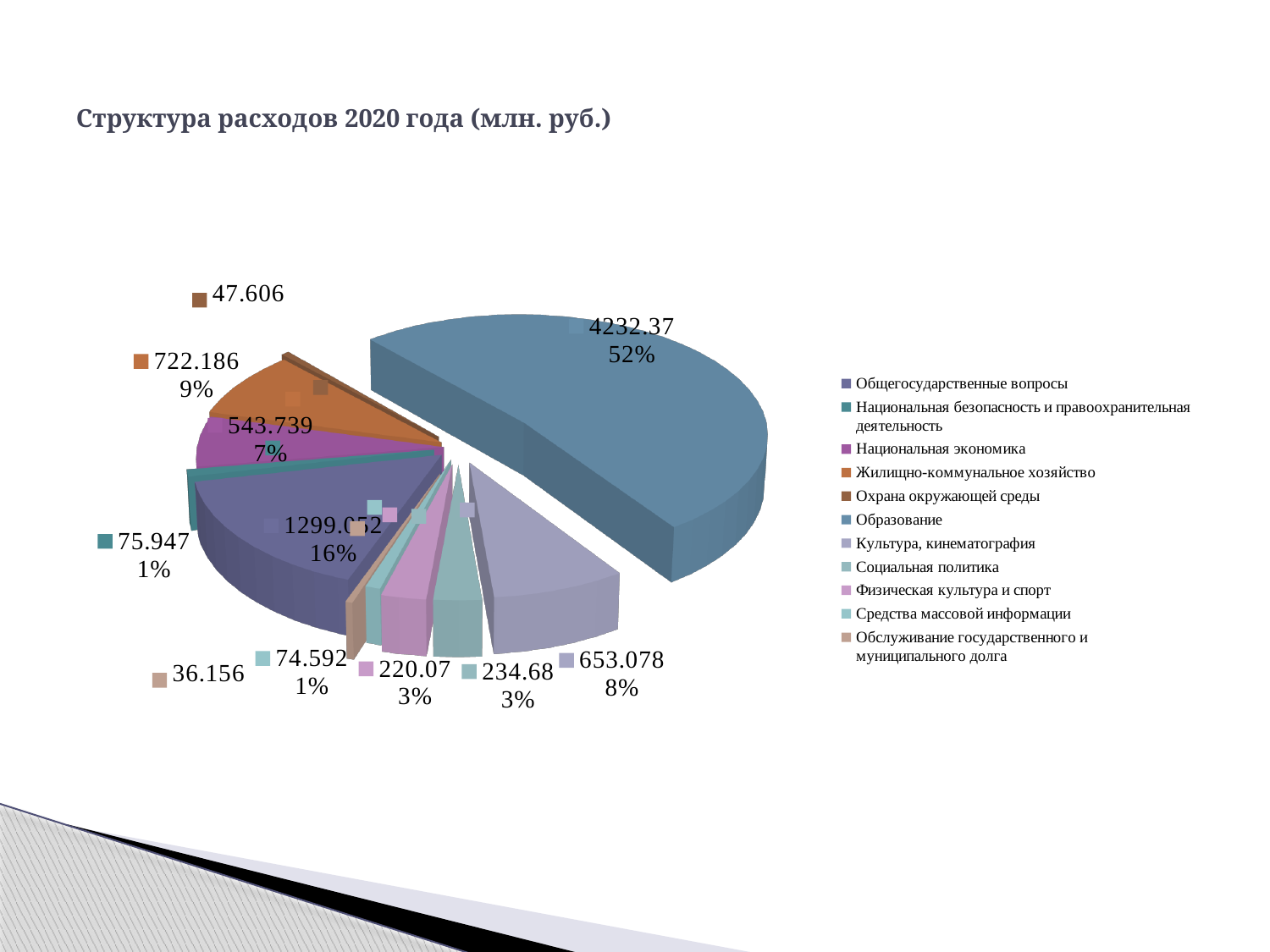
What is the value for Жилищно-коммунальное хозяйство? 722.186 Which category has the largest slice? Образование What kind of chart is shown on the slide? pie chart Which is larger, Социальная политика or Физическая культура и спорт? Социальная политика What is the difference between the values for Жилищно-коммунальное хозяйство and Культура, кинематография? 69.108 How many categories does the legend list? 11 What share of the pie does Образование take? 52% What is the title of the chart? Структура расходов 2020 года (млн. руб.) What share of the pie does Национальная экономика take? 7% What is the value for Образование? 4232.37 What is the value for Культура, кинематография? 653.078 Which category has the smallest slice? Обслуживание государственного и муниципального долга